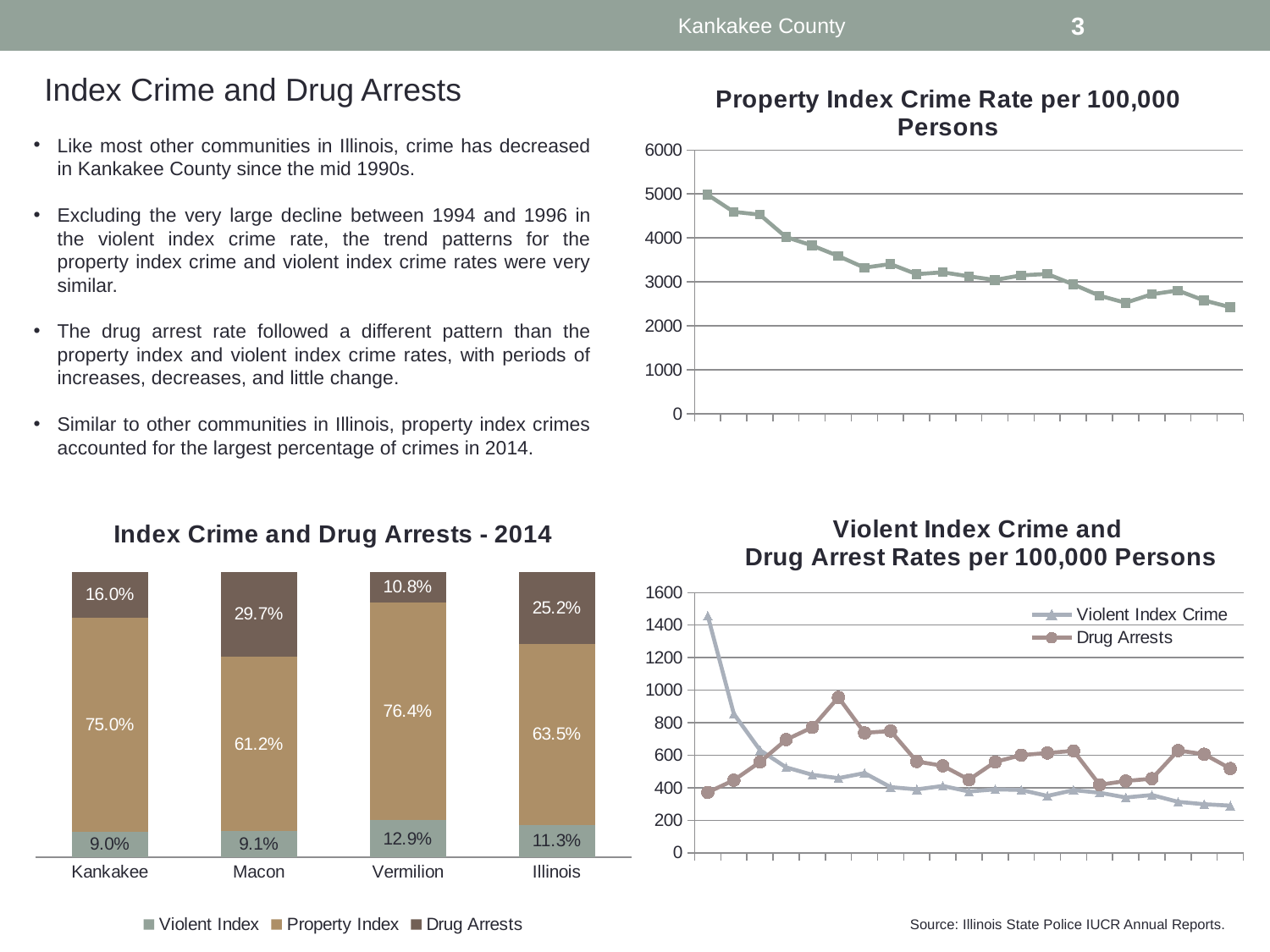
In the 'Violent Index Crime and Drug Arrest Rates per 100,000 Persons' chart, is the first Violent Index Crime value greater or less than 1200? greater In the 'Index Crime and Drug Arrests - 2014' chart, which is larger: the Violent Index value for Illinois or for Macon? Illinois How many categories are shown on the x axis of the 'Index Crime and Drug Arrests - 2014' chart? 4 In the 'Index Crime and Drug Arrests - 2014' chart, which category has the lowest Drug Arrests value? Vermilion In the 'Index Crime and Drug Arrests - 2014' chart, which category has the highest Property Index value? Vermilion How many series does the legend of the 'Index Crime and Drug Arrests - 2014' chart list? 3 In the 'Property Index Crime Rate per 100,000 Persons' chart, do the values generally rise or fall along the x axis? Fall In the 'Index Crime and Drug Arrests - 2014' chart, what is the Property Index value for Kankakee? 75.0% What kind of chart is the 'Property Index Crime Rate per 100,000 Persons' chart? Line chart In the 'Index Crime and Drug Arrests - 2014' chart, what is the difference between the Drug Arrests values for Macon and Kankakee? 13.7% In the 'Index Crime and Drug Arrests - 2014' chart, what is the Violent Index value for Vermilion? 12.9% In the 'Index Crime and Drug Arrests - 2014' chart, what is the Drug Arrests value for Macon? 29.7%